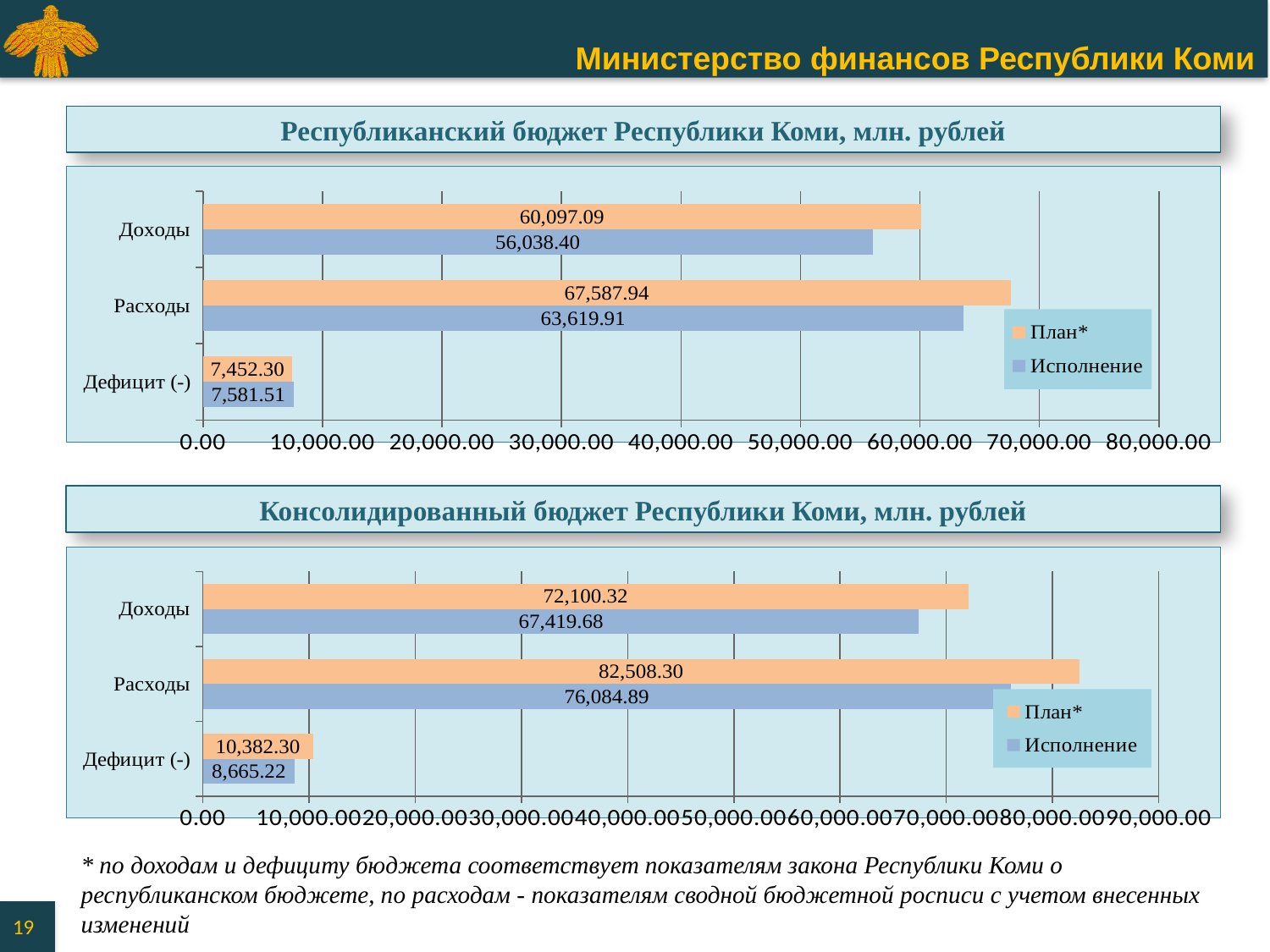
In the chart titled 'Республиканский бюджет Республики Коми, млн. рублей', what is the План* value for Доходы? 60,097.09 In the chart titled 'Республиканский бюджет Республики Коми, млн. рублей', what is the Исполнение value for Расходы? 63,619.91 What type of chart is the chart titled 'Консолидированный бюджет Республики Коми, млн. рублей'? Bar chart In the chart titled 'Консолидированный бюджет Республики Коми, млн. рублей', what is the difference between the План* and Исполнение values for Расходы? 6,423.41 How many series does the legend list in the chart titled 'Республиканский бюджет Республики Коми, млн. рублей'? 2 In the chart titled 'Консолидированный бюджет Республики Коми, млн. рублей', which category has the lowest Исполнение value? Дефицит (-) In the chart titled 'Консолидированный бюджет Республики Коми, млн. рублей', what is the Исполнение value for Дефицит (-)? 8,665.22 In the chart titled 'Консолидированный бюджет Республики Коми, млн. рублей', is the Исполнение value for Доходы greater or less than 70,000.00? less In the chart titled 'Консолидированный бюджет Республики Коми, млн. рублей', what is the План* value for Расходы? 82,508.30 In the chart titled 'Республиканский бюджет Республики Коми, млн. рублей', what is the difference between the План* and Исполнение values for Доходы? 4,058.69 In the chart titled 'Республиканский бюджет Республики Коми, млн. рублей', which category has the highest План* value? Расходы In the chart titled 'Республиканский бюджет Республики Коми, млн. рублей', is the Исполнение value for Дефицит (-) larger or smaller than the План* value? larger